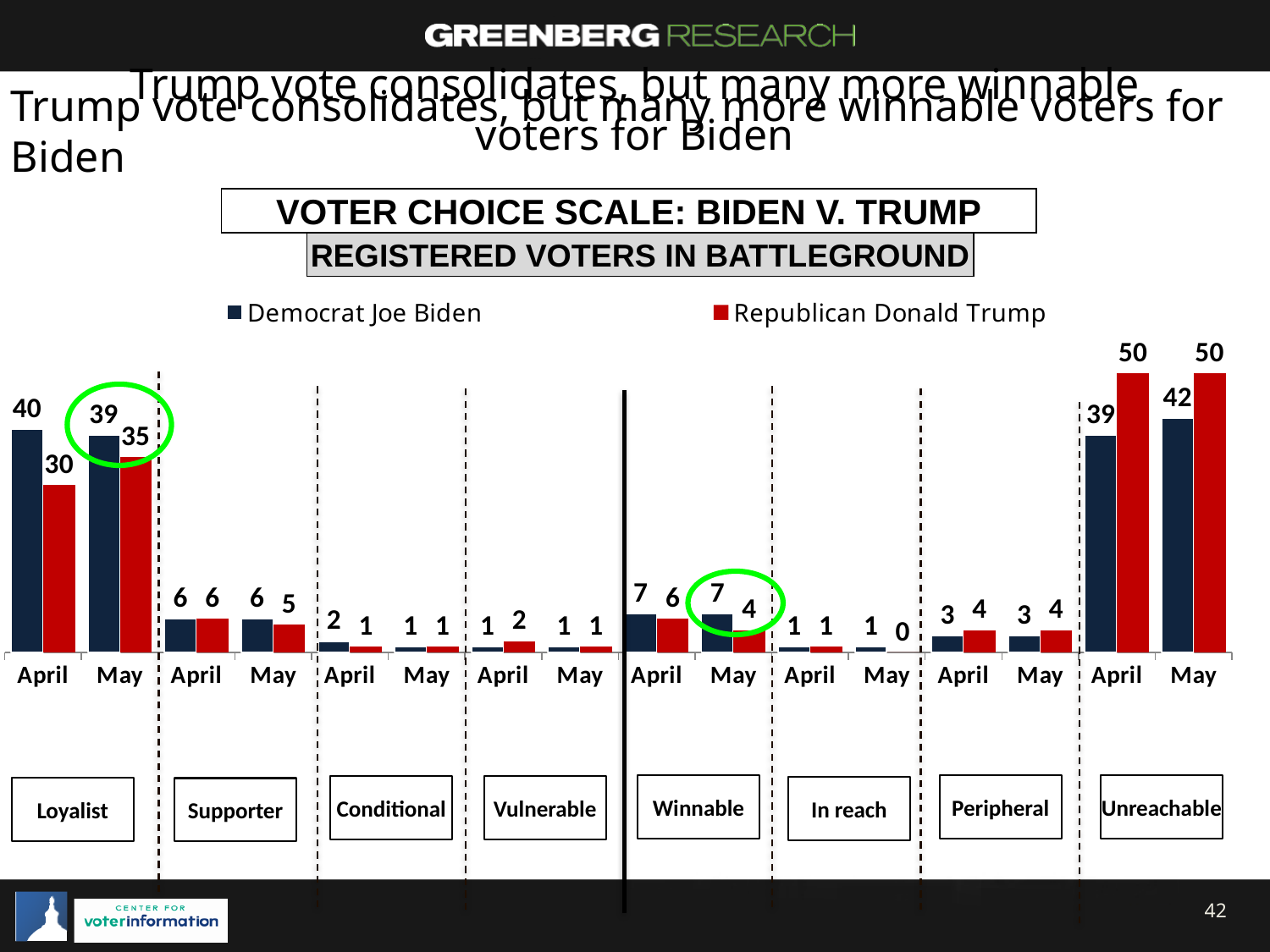
How many series does the legend list? 2 What is the value for Republican Donald Trump among Loyalist voters in May? 35 What kind of chart is shown on the slide? Bar chart Which voter group has the highest value for Republican Donald Trump? Unreachable Among Winnable voters in May, which is larger: the value for Democrat Joe Biden or Republican Donald Trump? Democrat Joe Biden What is the difference between Republican Donald Trump and Democrat Joe Biden among Unreachable voters in April? 11 Among Peripheral voters in April, which is larger: the value for Democrat Joe Biden or Republican Donald Trump? Republican Donald Trump What is the value for Democrat Joe Biden among Winnable voters in May? 7 What is the value for Republican Donald Trump among Unreachable voters in May? 50 What is the value for Republican Donald Trump among In reach voters in May? 0 What is the difference between Democrat Joe Biden and Republican Donald Trump among Loyalist voters in April? 10 What is the value for Democrat Joe Biden among Loyalist voters in April? 40